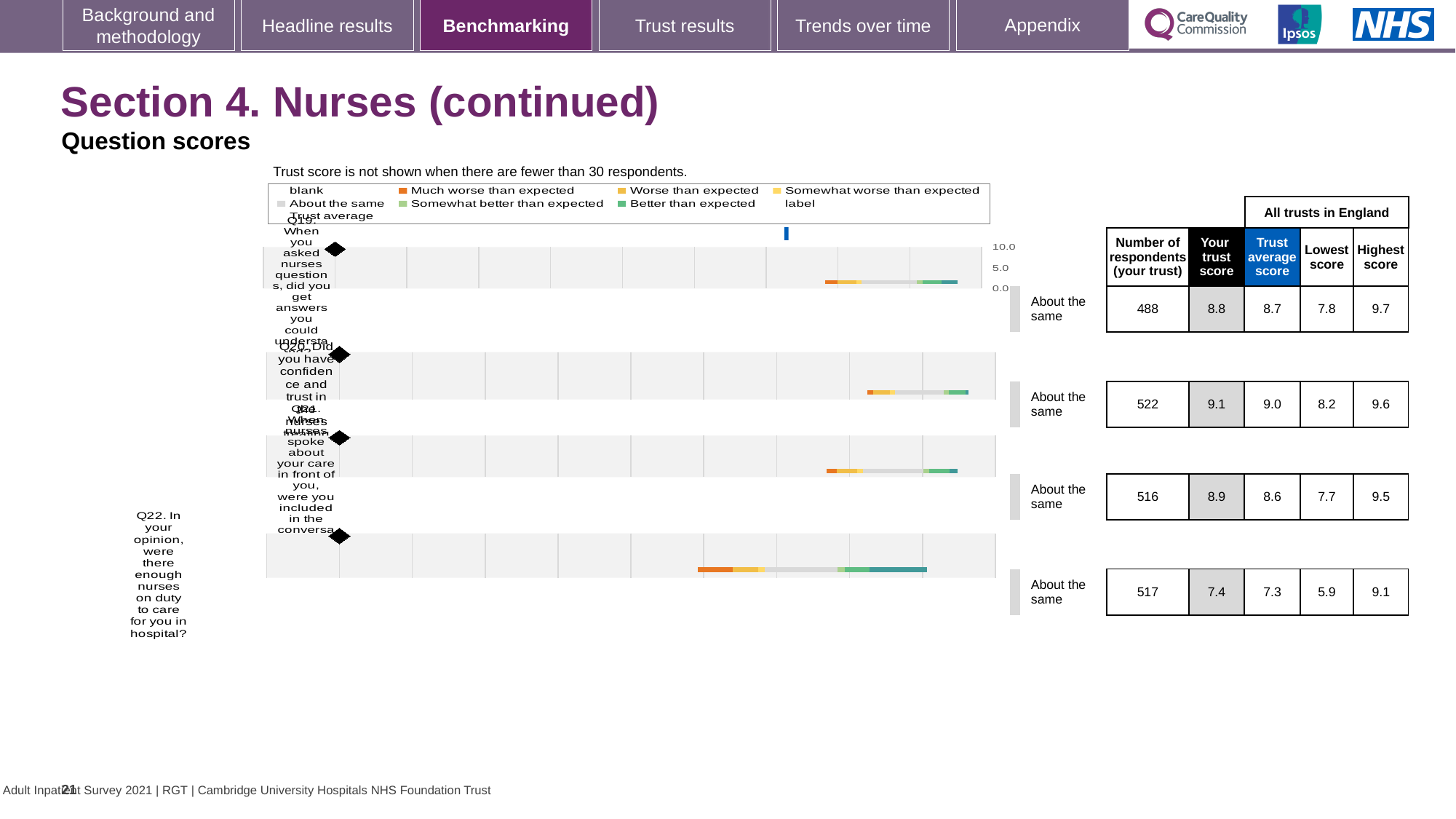
Is the trust score for Q22 greater or less than 5.0? greater How many questions are plotted in the chart on this slide? 4 What is the difference between the trust score and the trust average score for Q19? 0.1 What benchmark category label is shown next to each of the four questions? About the same Which question has the lowest 'Your trust score' on this slide? Q22 For Q21, which is larger: the trust's own score or the trust average score? Your trust score (8.9) What is the highest score across all trusts in England for Q20? 9.6 What is the difference between the highest and lowest scores in England for Q22? 3.2 What is the 'Your trust score' for Q22 (were there enough nurses on duty to care for you in hospital)? 7.4 What is the lowest score across all trusts in England for Q22? 5.9 Which question has the highest 'Your trust score' on this slide? Q20 How many respondents from the trust answered Q20 (did you have confidence and trust in the nurses treating you)? 522